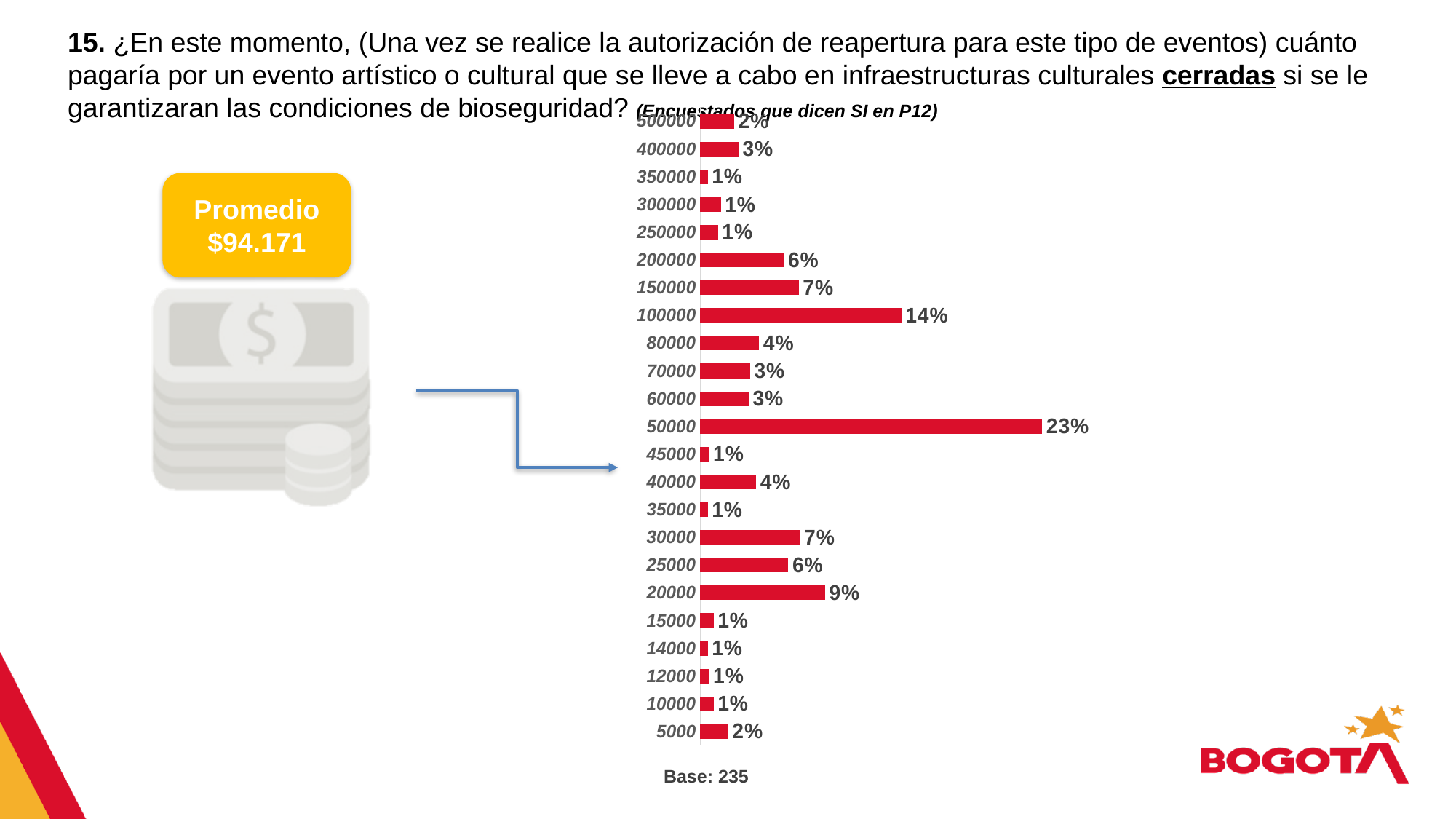
Which has a higher percentage, 150000 or 80000? 150000 What percentage of respondents would pay 50000? 23% Which has a higher percentage, 20000 or 30000? 20000 What percentage of respondents would pay 100000? 14% What percentage of respondents would pay 20000? 9% What is the average (Promedio) amount shown on the slide? $94.171 Which amount has the highest percentage of respondents? 50000 How many amount categories are shown in the chart? 23 What kind of chart is shown on the slide? Bar chart What percentage of respondents would pay 200000? 6% What is the difference in percentage points between the 50000 and 100000 bars? 9 percentage points What percentage of respondents would pay 400000? 3%